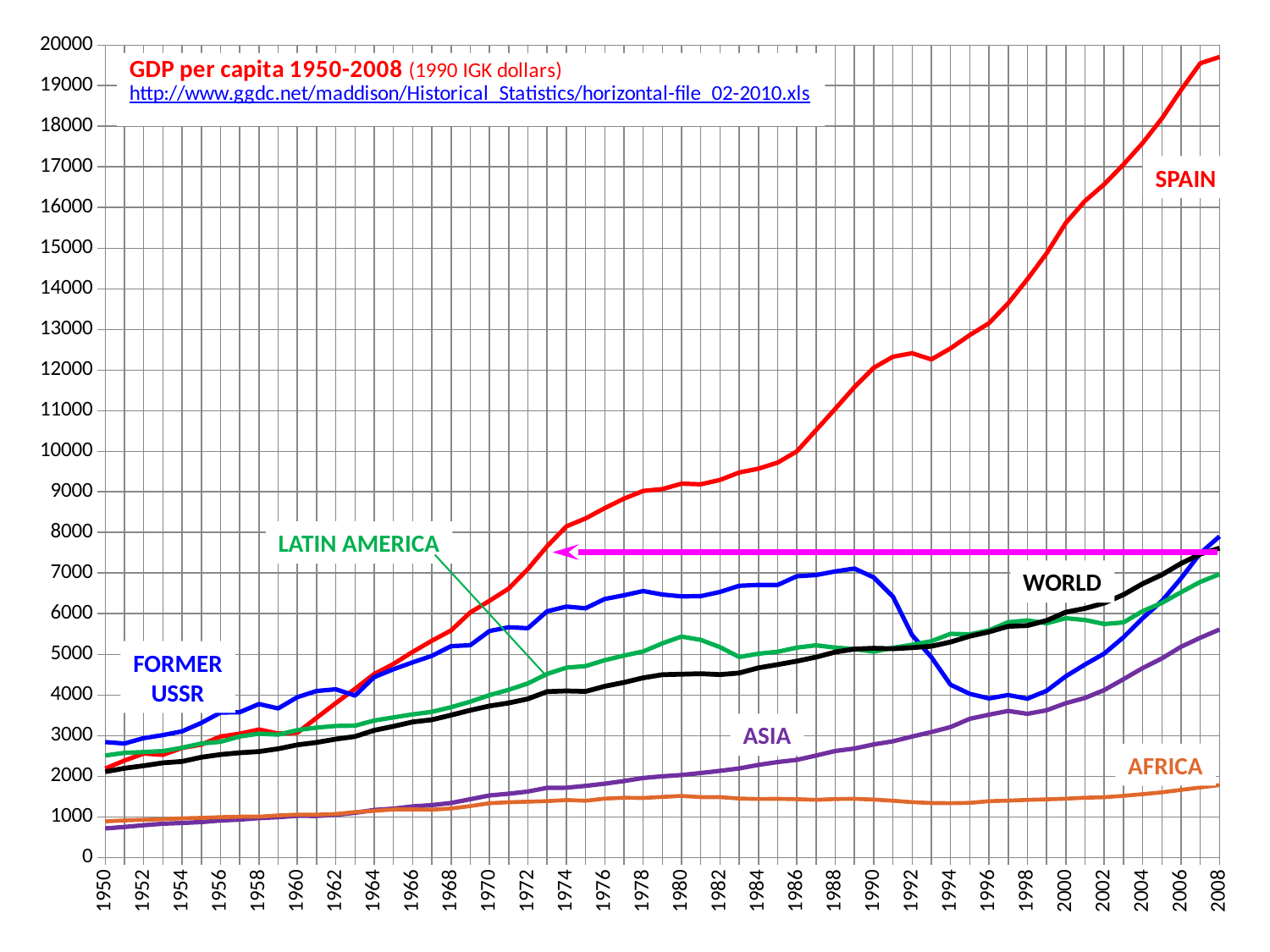
In 1990, which is larger: the value for FORMER USSR or the value for WORLD? FORMER USSR Is the value for SPAIN in 2008 greater or less than 18000? greater How many series are labelled on the chart? 6 Which series has the lowest value in 2008? AFRICA Is the value for ASIA in 2008 greater or less than 5000? greater Does the FORMER USSR line rise or fall between 1990 and 1996? fall Which series has the highest value in 2008? SPAIN Is the value for AFRICA in 2008 greater or less than 2000? less What is the title of the chart? GDP per capita 1950-2008 Does the SPAIN line rise or fall overall from 1950 to 2008? rise What kind of chart is shown on the slide? line chart